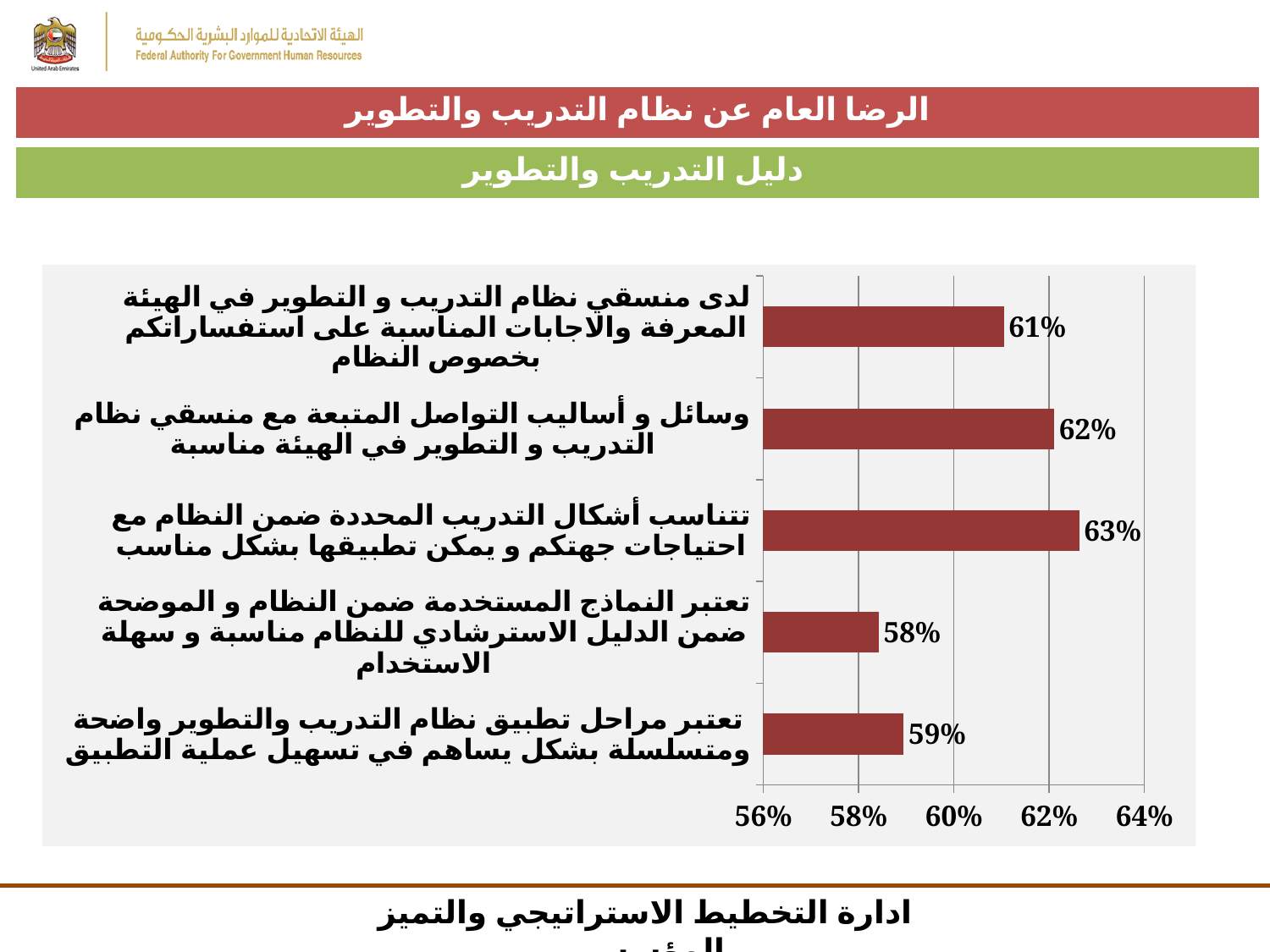
Which category has the highest value? تتناسب أشكال التدريب المحددة ضمن النظام مع احتياجات جهتكم و يمكن تطبيقها بشكل مناسب What is the value for the category "تعتبر النماذج المستخدمة ضمن النظام و الموضحة ضمن الدليل الاسترشادي للنظام مناسبة و سهلة الاستخدام"? 58% How many categories are shown in the chart? 5 What is the maximum value shown on the horizontal axis of the chart? 64% Which category has the lowest value? تعتبر النماذج المستخدمة ضمن النظام و الموضحة ضمن الدليل الاسترشادي للنظام مناسبة و سهلة الاستخدام What is the value for the top bar, "لدى منسقي نظام التدريب و التطوير في الهيئة المعرفة والاجابات المناسبة على استفساراتكم بخصوص النظام"? 61% What is the difference between the highest value (63%) and the lowest value (58%)? 5% Which is larger: the value for "وسائل و أساليب التواصل المتبعة مع منسقي نظام التدريب و التطوير في الهيئة مناسبة" or the value for "تعتبر مراحل تطبيق نظام التدريب والتطوير واضحة ومتسلسلة بشكل يساهم في تسهيل عملية التطبيق"? وسائل و أساليب التواصل المتبعة مع منسقي نظام التدريب و التطوير في الهيئة مناسبة What is the value for the bottom bar, "تعتبر مراحل تطبيق نظام التدريب والتطوير واضحة ومتسلسلة بشكل يساهم في تسهيل عملية التطبيق"? 59% What kind of chart is shown on the slide? bar chart What is the value for the category "وسائل و أساليب التواصل المتبعة مع منسقي نظام التدريب و التطوير في الهيئة مناسبة"? 62% Is the value for "تتناسب أشكال التدريب المحددة ضمن النظام مع احتياجات جهتكم و يمكن تطبيقها بشكل مناسب" greater or less than 60%? greater